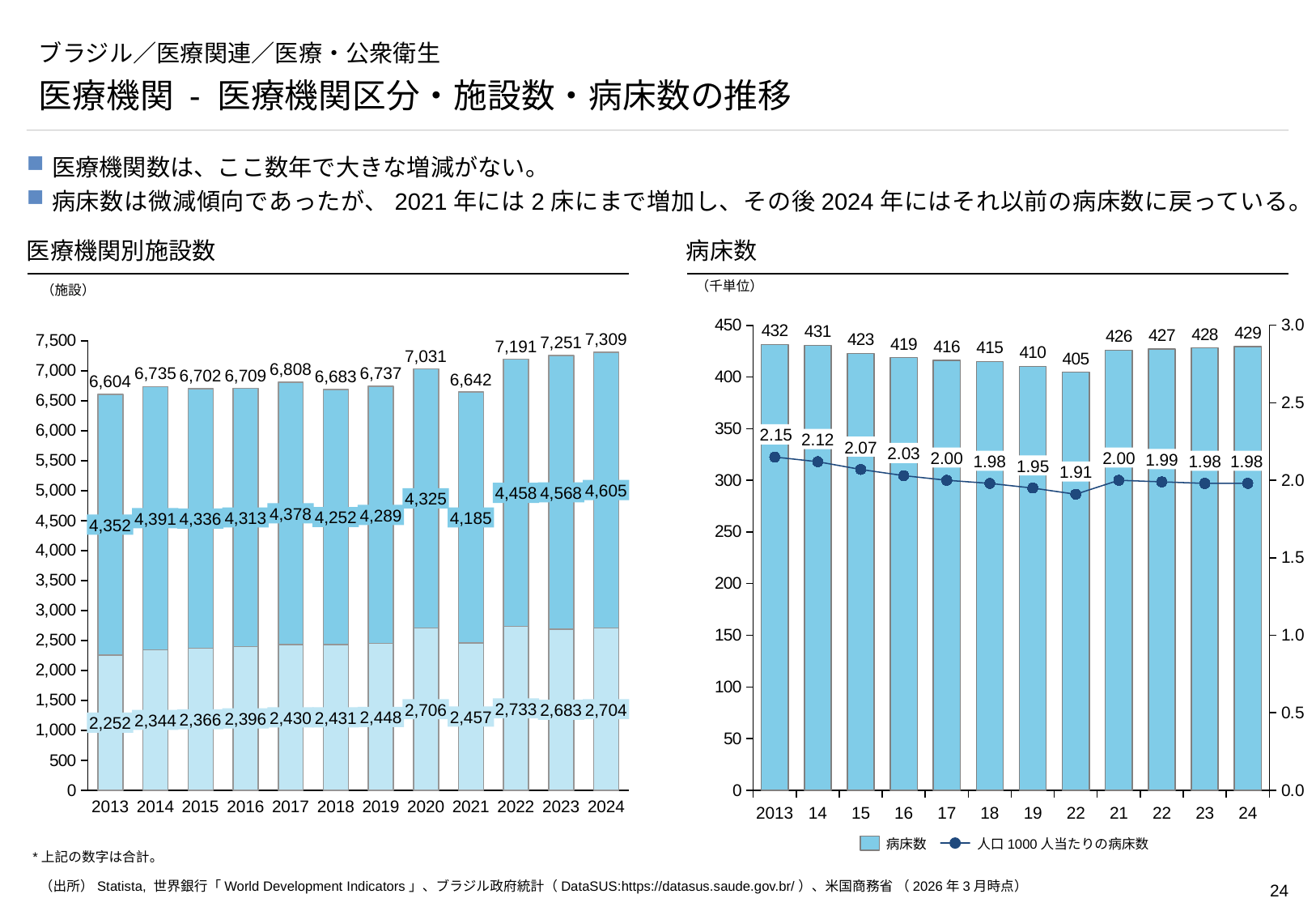
In the 病床数 chart on the right, how many series does the legend list? 2 In the 医療機関別施設数 chart on the left, what is the total number of facilities shown for 2024? 7,309 In the 医療機関別施設数 chart on the left, how many years are shown on the x axis? 12 In the 医療機関別施設数 chart on the left, what is the difference between the total for 2024 and the total for 2013? 705 What type of chart is the 病床数 chart on the right? Combined bar and line chart In the 病床数 chart on the right, what is the difference between the bar value for 2013 and the bar value for 2024? 3 In the 病床数 chart on the right, which year has the lowest bar value? 2022 (405) In the 病床数 chart on the right, what is the number of beds (bar value) for 2013? 432 In the 医療機関別施設数 chart on the left, what is the value of the lower (lighter) segment for 2020? 2,706 In the 医療機関別施設数 chart on the left, is the upper (darker) segment value for 2021 larger or smaller than that for 2022? smaller In the 病床数 chart on the right, what is the beds per 1,000 population (line value) for 2021? 2.00 In the 医療機関別施設数 chart on the left, which year has the lowest total? 2013